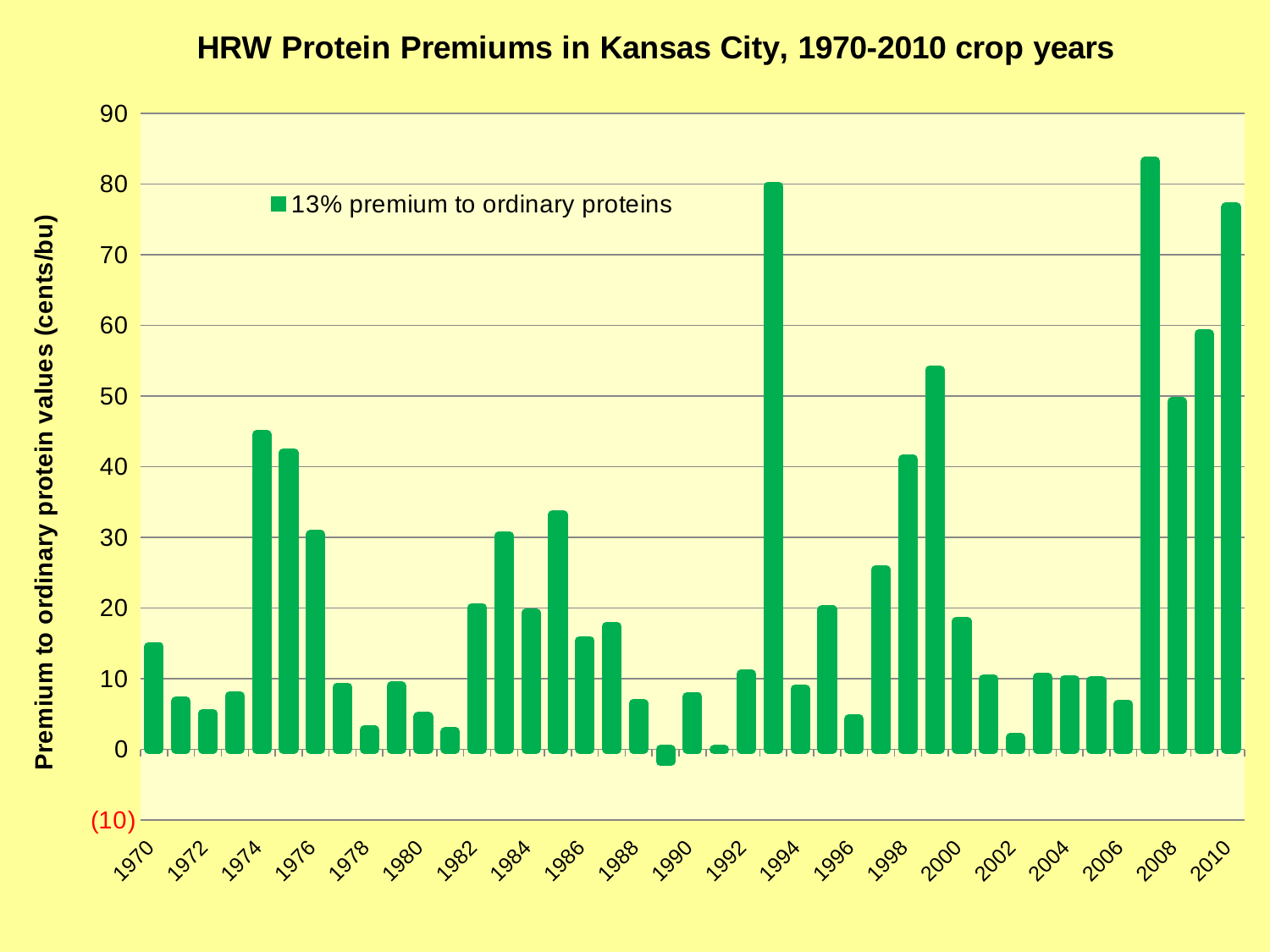
What kind of chart is shown on the slide? bar chart Is the value for 1978 greater or less than 10? less Is the value for 2010 greater or less than 70? greater Which has the larger premium, 1998 or 1999? 1999 What is the label on the vertical axis? Premium to ordinary protein values (cents/bu) Is the value for 1993 greater or less than 70? greater How many series does the legend list? 1 Which crop year has the lowest premium? 1989 Which crop year has the highest premium? 2007 Which has the larger premium, 2008 or 2009? 2009 What is the title of the chart? HRW Protein Premiums in Kansas City, 1970-2010 crop years